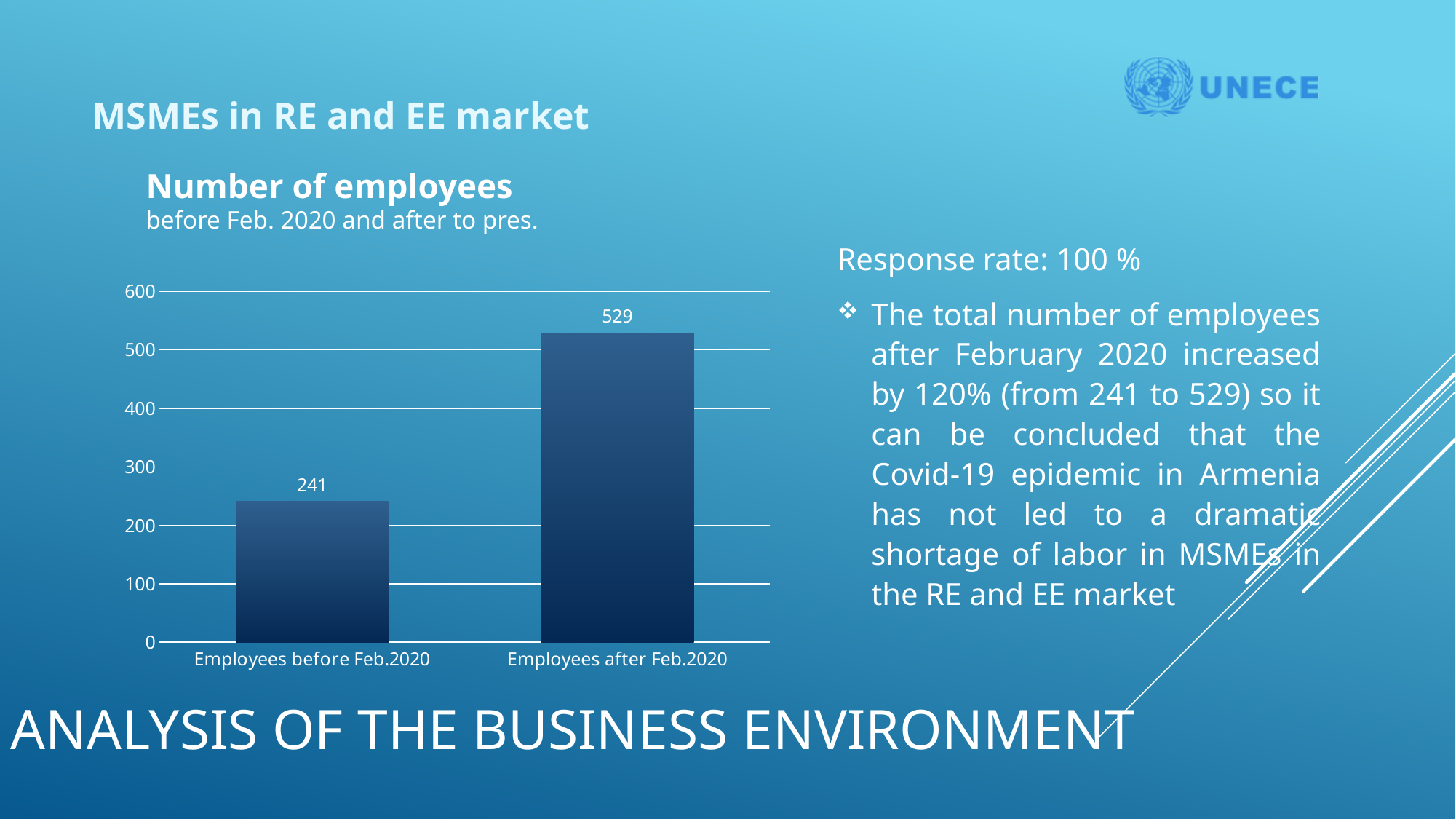
What is the value for Employees after Feb.2020? 529 Is the value for Employees after Feb.2020 greater or less than 500? greater Is the value for Employees before Feb.2020 greater or less than 300? less Which category has the lowest value? Employees before Feb.2020 Which category has the highest value? Employees after Feb.2020 What kind of chart is shown on the slide? bar chart How many categories are shown on the chart? 2 Which is larger, the value for Employees before Feb.2020 or the value for Employees after Feb.2020? Employees after Feb.2020 What is the title of the chart? Number of employees Do the values rise or fall from left to right along the x axis? rise What is the value for Employees before Feb.2020? 241 What is the difference between the values for Employees after Feb.2020 and Employees before Feb.2020? 288